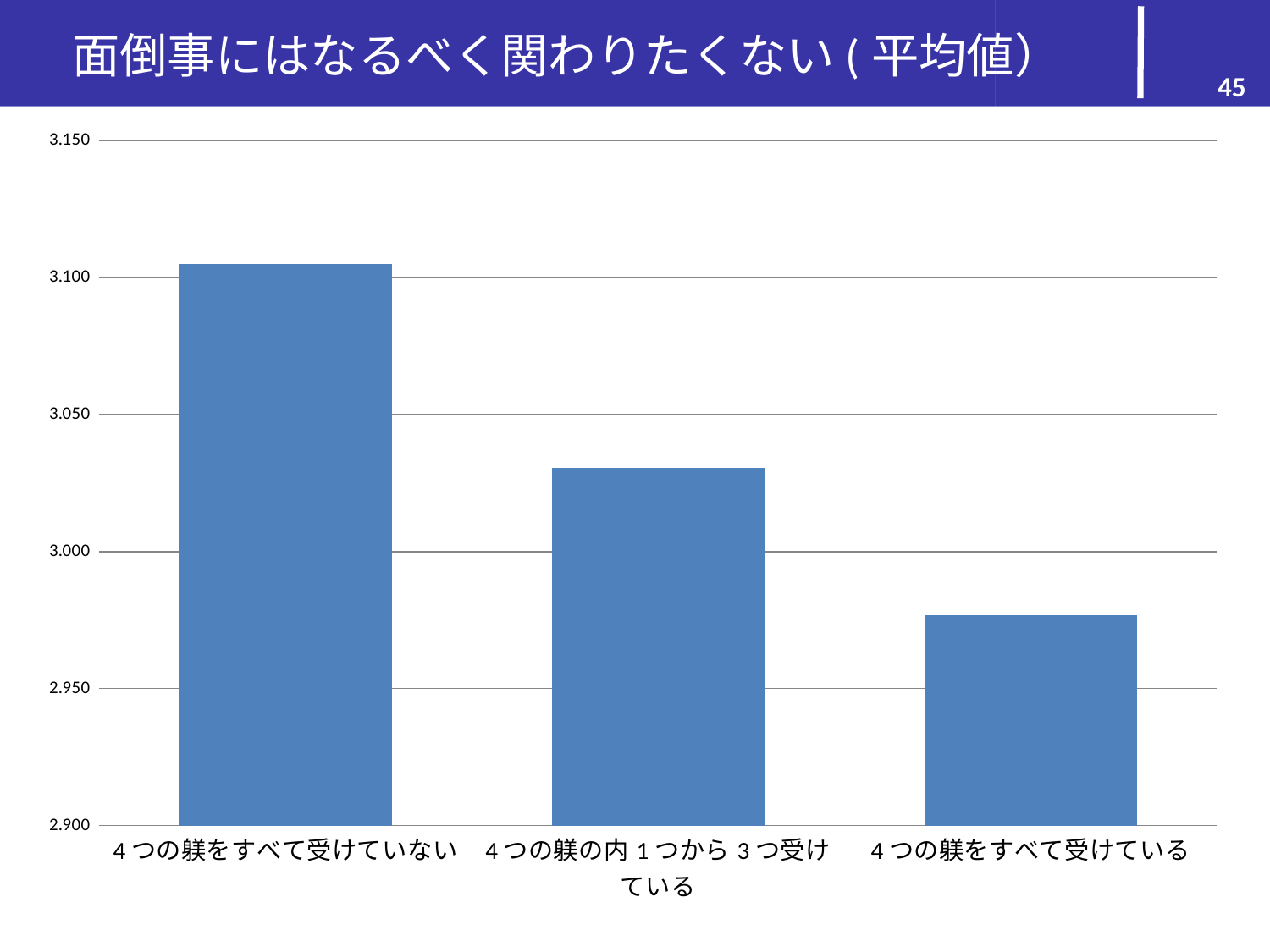
How many categories are shown on the x axis of the chart? 3 Is the value for 4つの躾の内1つから3つ受けている greater or less than 3.000? greater Is the value for 4つの躾をすべて受けている greater or less than 2.950? greater Is the value for 4つの躾をすべて受けていない greater or less than 3.050? greater Which category has the highest value in the chart? 4つの躾をすべて受けていない What kind of chart is shown on the slide? bar chart What is the title of the slide containing the chart? 面倒事にはなるべく関わりたくない(平均値) Do the values rise or fall from left to right across the categories? fall Which is larger, the value for 4つの躾の内1つから3つ受けている or the value for 4つの躾をすべて受けている? 4つの躾の内1つから3つ受けている Which category has the lowest value in the chart? 4つの躾をすべて受けている